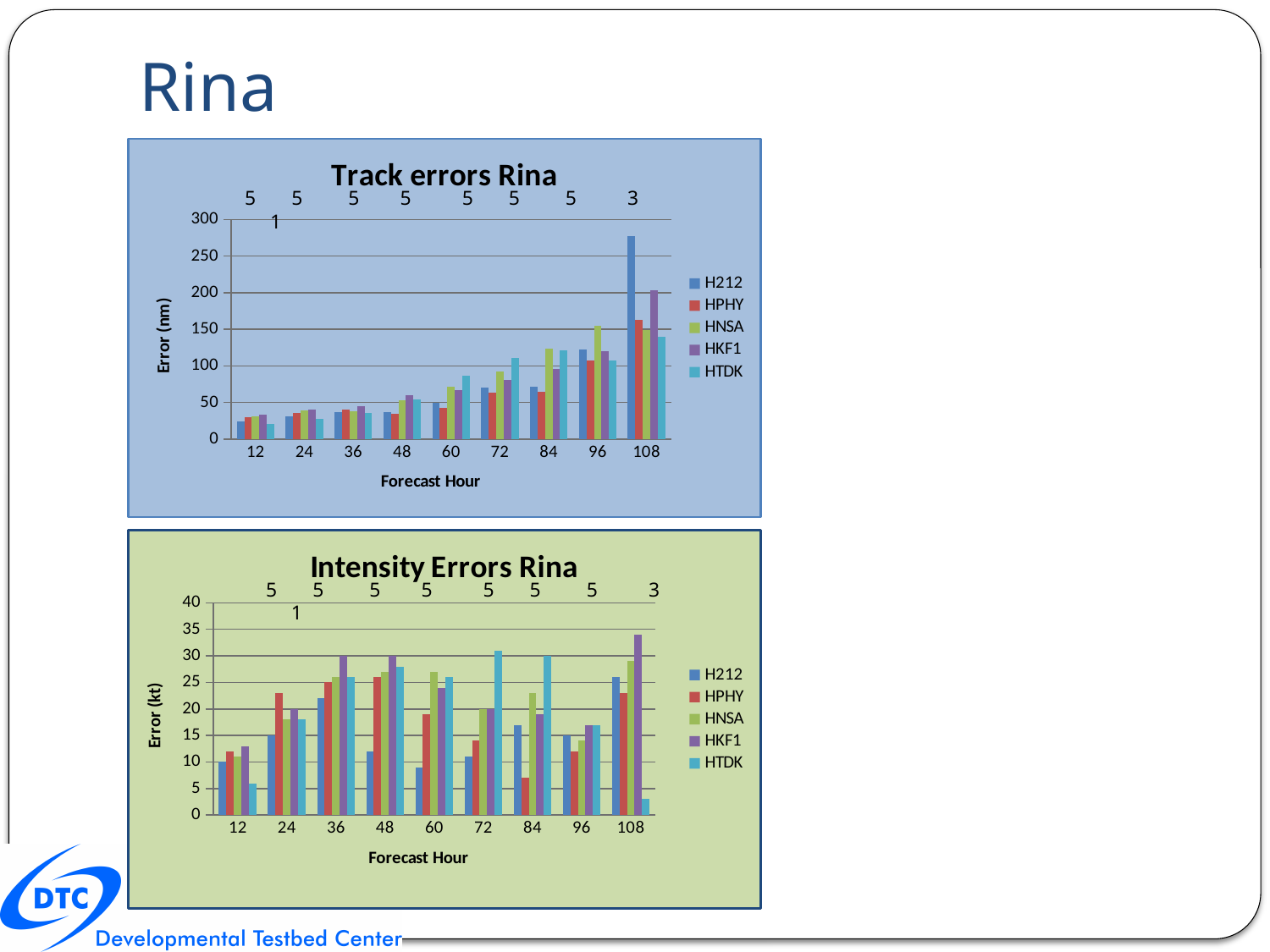
In the Track errors Rina chart, which series has the highest bar at forecast hour 108? H212 In the Intensity Errors Rina chart, which is larger at forecast hour 24: HPHY or H212? HPHY In the Track errors Rina chart, which is larger at forecast hour 108: H212 or HPHY? H212 In the Track errors Rina chart, is the value for H212 at forecast hour 108 greater or less than 250? greater In the Track errors Rina chart, is the value for HTDK at forecast hour 12 greater or less than 50? less In the Track errors Rina chart, do the track errors generally rise or fall as the forecast hour increases? rise In the Track errors Rina chart, how many series does the legend list? 5 What is the y-axis label of the Intensity Errors Rina chart? Error (kt) In the Intensity Errors Rina chart, which series has the lowest bar at forecast hour 108? HTDK What kind of chart is the Intensity Errors Rina chart? bar chart In the Track errors Rina chart, how many forecast hours are shown on the x axis? 9 In the Intensity Errors Rina chart, is the value for H212 at forecast hour 60 greater or less than 10? less